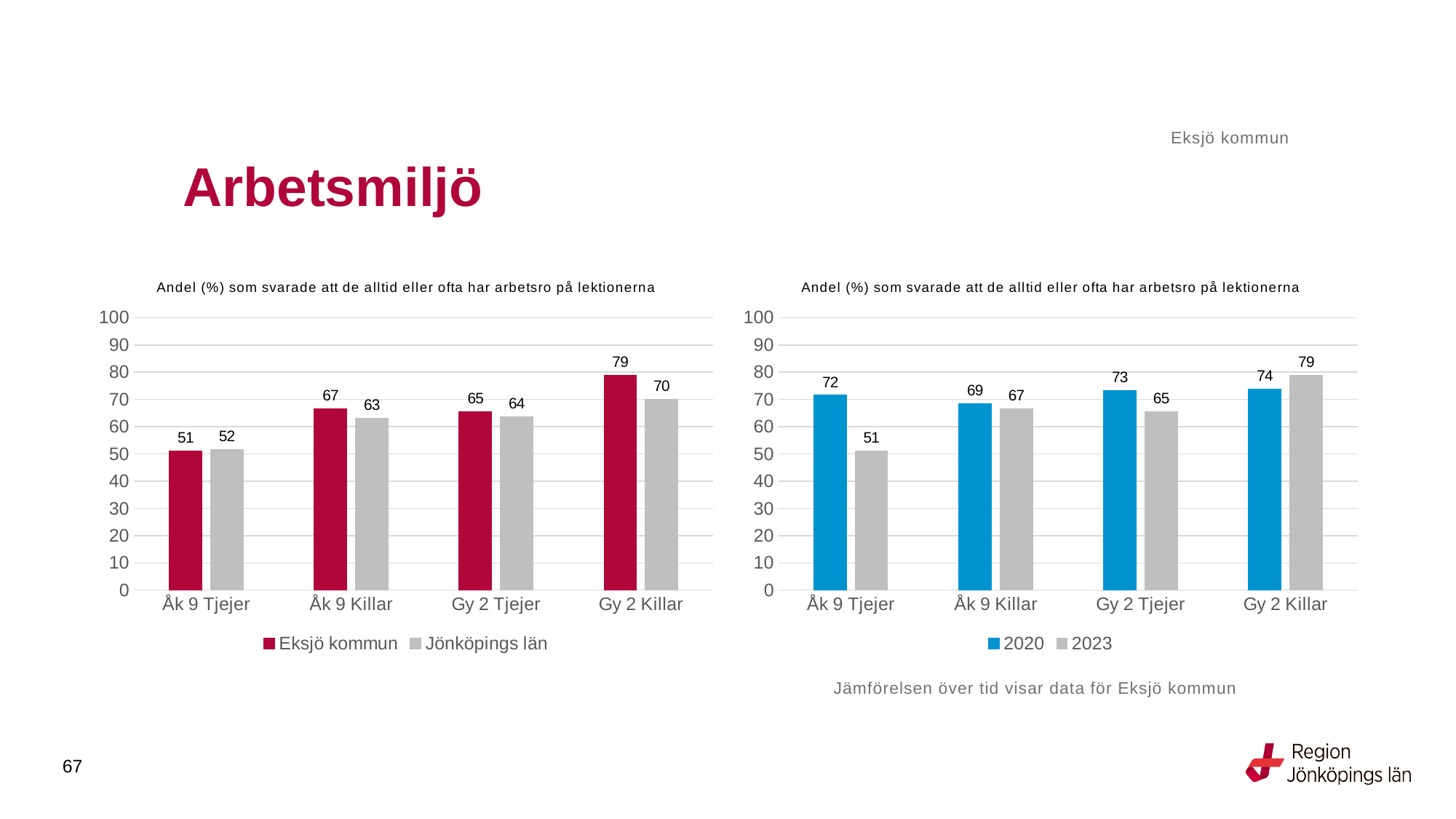
In the right chart, what is the 2023 value for Åk 9 Tjejer? 51 In the right chart, what is the difference between the 2020 and 2023 values for Åk 9 Tjejer? 21 How many categories are shown on the x axis of the left chart? 4 In the left chart, what is the value for Jönköpings län for Åk 9 Killar? 63 In the left chart, what is the value for Eksjö kommun for Gy 2 Killar? 79 How many series does the legend of the right chart list? 2 In the right chart, which is larger for Gy 2 Killar: the 2020 value or the 2023 value? 2023 In the left chart, what is the difference between Eksjö kommun and Jönköpings län for Gy 2 Killar? 9 In the right chart, what is the 2020 value for Gy 2 Tjejer? 73 What type of chart is the left chart? Bar chart In the left chart, which category has the highest Eksjö kommun value? Gy 2 Killar In the right chart, which category has the lowest 2023 value? Åk 9 Tjejer